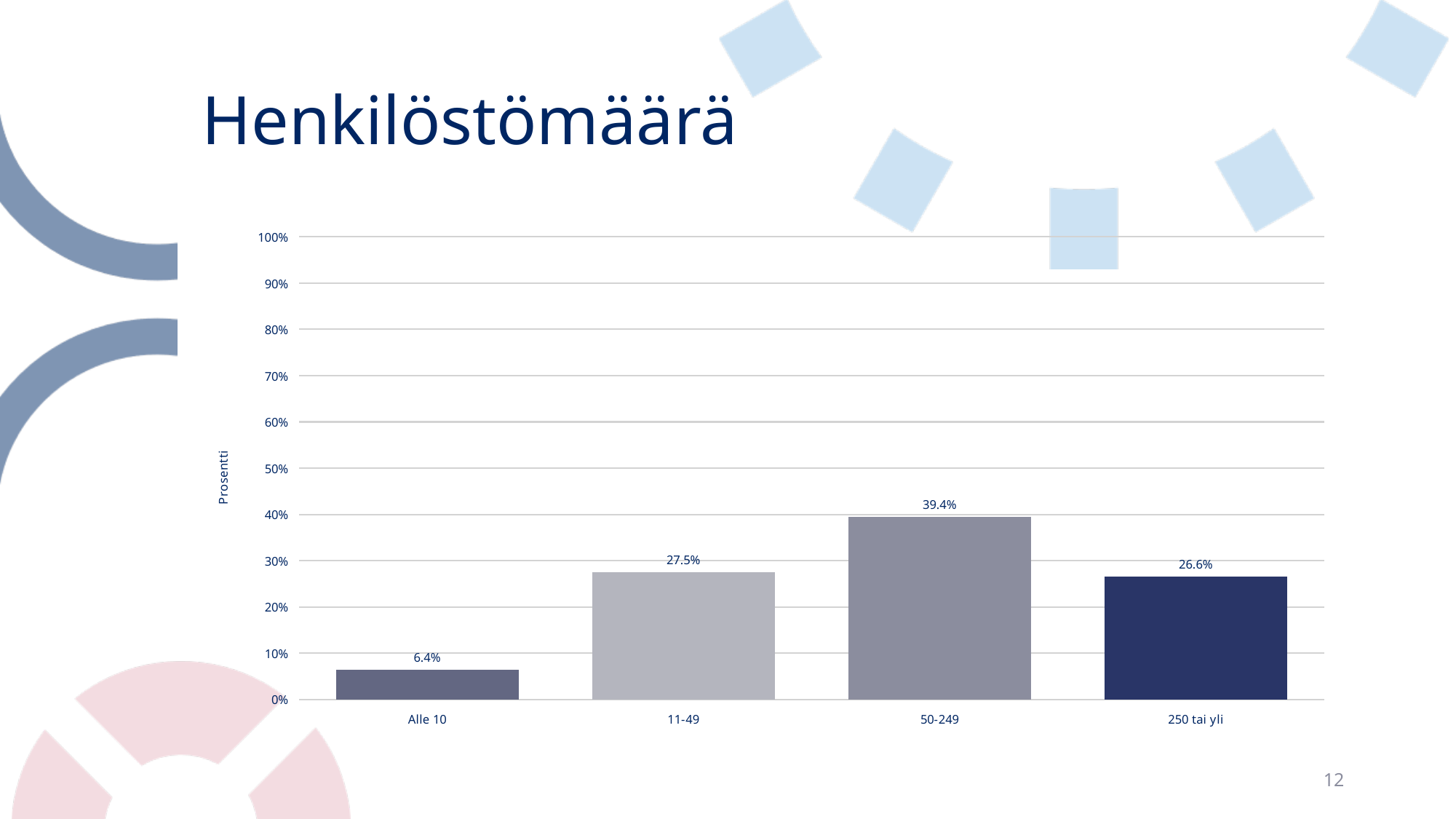
Which category has the highest value? 50-249 What is the difference between the values for "50-249" and "11-49"? 11.9% Which is larger, the value for "50-249" or the value for "250 tai yli"? 50-249 What kind of chart is shown on the slide? Bar chart What is the title of the slide containing the chart? Henkilöstömäärä What is the value for the "11-49" category? 27.5% What is the value for the "50-249" category? 39.4% How many categories are shown on the x axis? 4 What is the value for the "250 tai yli" category? 26.6% What is the value for the "Alle 10" category? 6.4% What is the difference between the values for "11-49" and "Alle 10"? 21.1% Which category has the lowest value? Alle 10